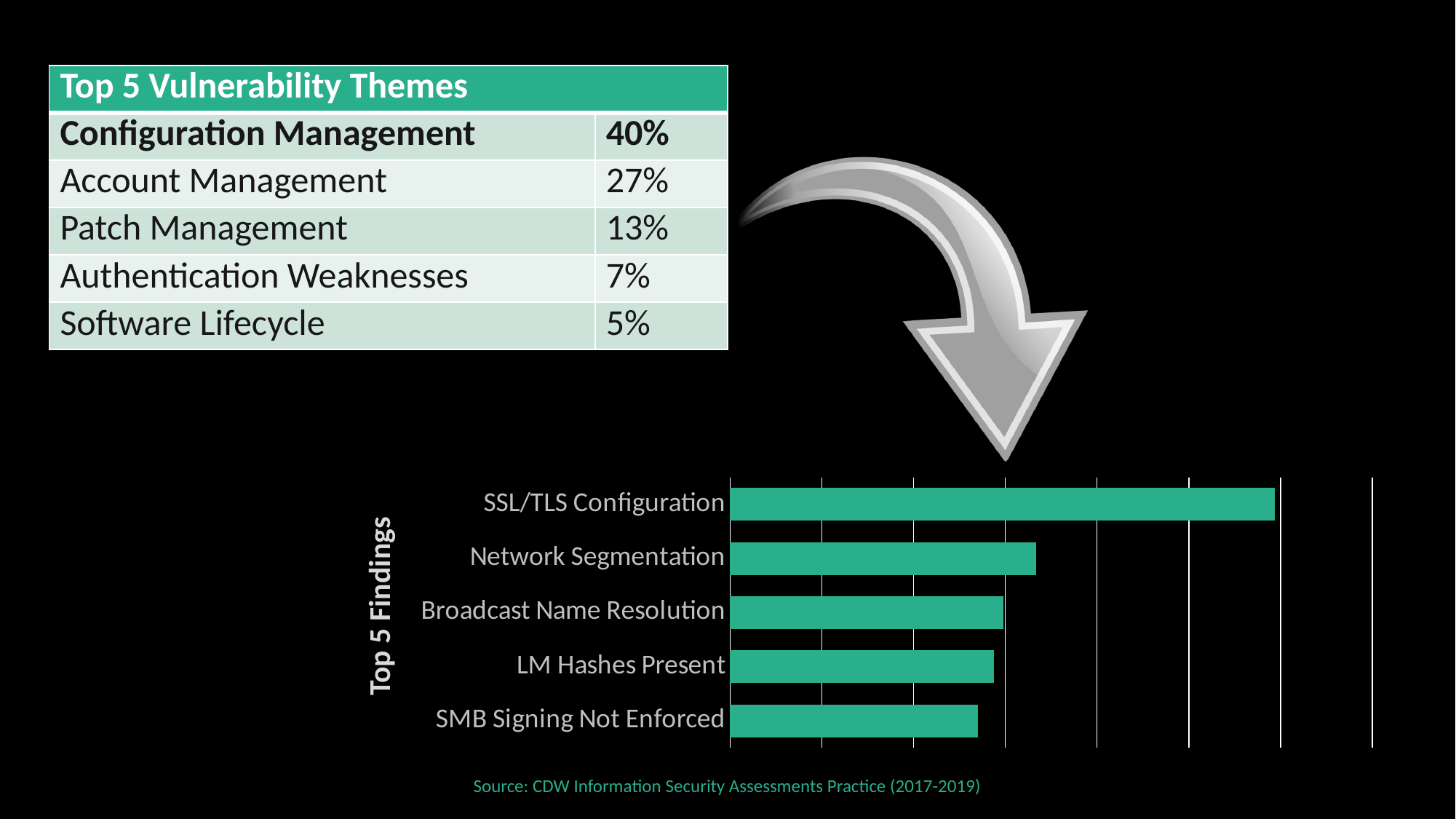
In the Top 5 Vulnerability Themes table, what percentage is shown for Configuration Management? 40% How many findings are plotted in the Top 5 Findings bar chart? 5 In the Top 5 Findings bar chart, which has the larger value: SSL/TLS Configuration or Network Segmentation? SSL/TLS Configuration What is the axis title shown beside the category labels of the bar chart? Top 5 Findings What kind of chart is the Top 5 Findings chart? bar chart In the Top 5 Findings bar chart, which has the larger value: Network Segmentation or Broadcast Name Resolution? Network Segmentation In the Top 5 Vulnerability Themes table, what percentage is shown for Patch Management? 13% In the Top 5 Findings bar chart, do the bar lengths increase or decrease going from the top bar to the bottom bar? decrease In the Top 5 Findings bar chart, which finding has the shortest bar? SMB Signing Not Enforced What source is cited below the bar chart? CDW Information Security Assessments Practice (2017-2019) In the Top 5 Findings bar chart, which finding has the longest bar? SSL/TLS Configuration In the Top 5 Vulnerability Themes table, what is the difference between the Account Management and Software Lifecycle percentages? 22%